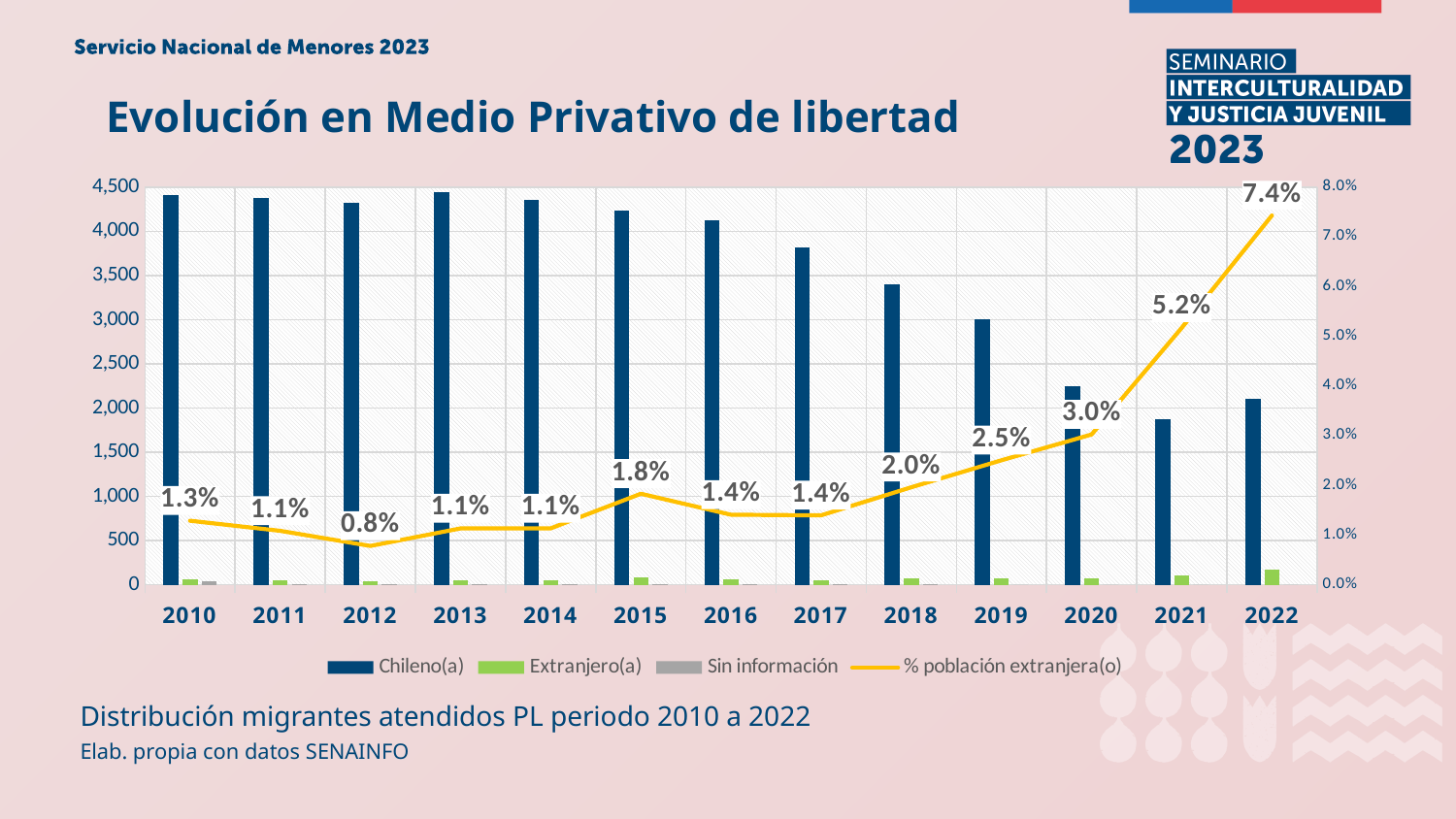
What is the difference in % población extranjera(o) between 2022 and 2021? 2.2 percentage points In which year is % población extranjera(o) highest? 2022 What is the value of % población extranjera(o) for 2012? 0.8% In which year is % población extranjera(o) lowest? 2012 How many series does the legend list? 4 What is the value of % población extranjera(o) for 2022? 7.4% What is the value of % población extranjera(o) for 2018? 2.0% Is the Chileno(a) value for 2010 greater or less than 4,000? greater What is the overall trend of % población extranjera(o) from 2012 to 2022? Rising Is the Chileno(a) value for 2021 greater or less than 2,000? less How many years are shown on the x axis? 13 Which year has a higher % población extranjera(o), 2015 or 2016? 2015